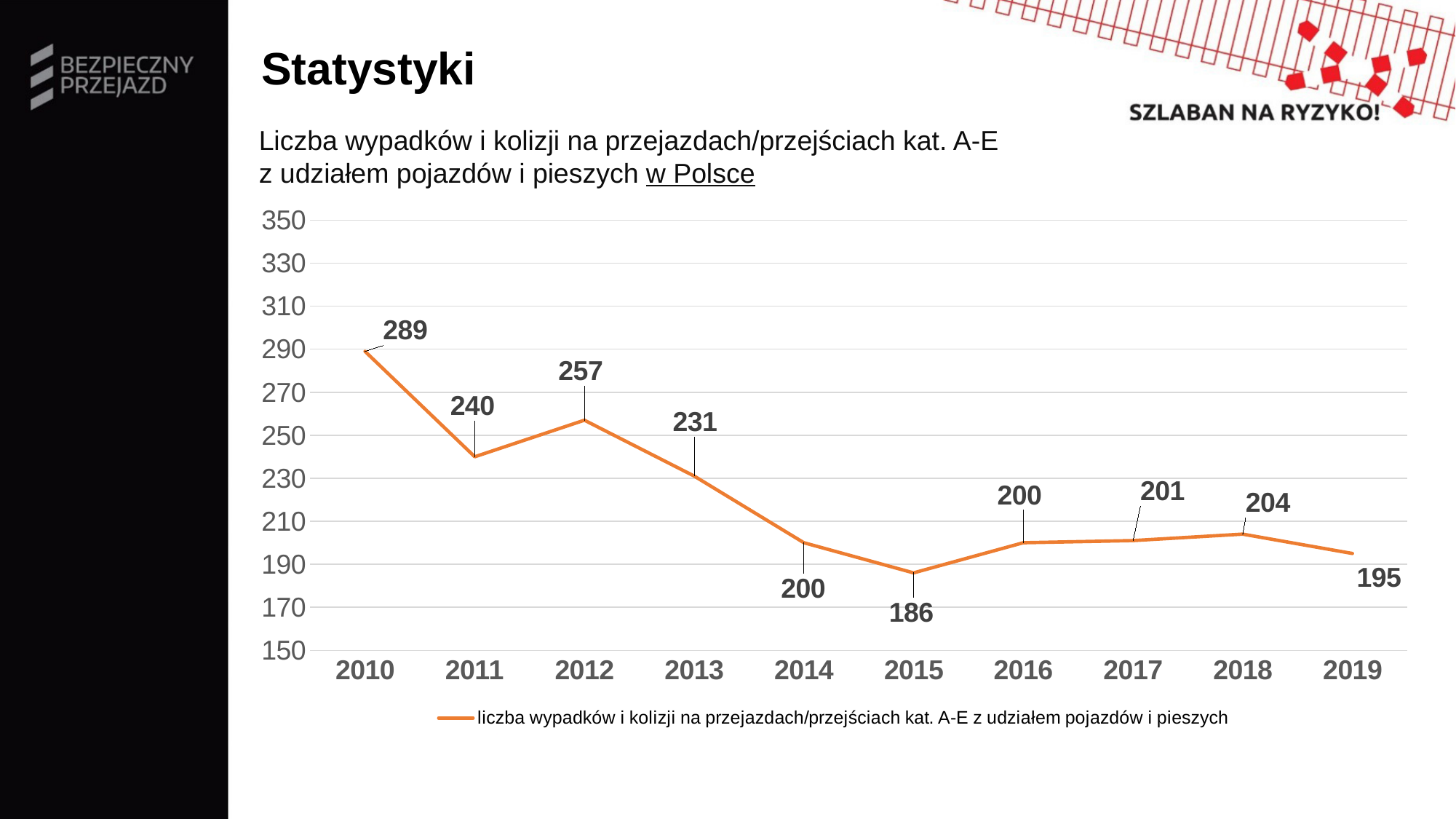
Which year has the lowest value? 2015 How many series does the legend list? 1 What is the value for 2010? 289 What is the value for 2019? 195 Which is larger, the value for 2011 or the value for 2012? 2012 Do the values generally rise or fall from 2010 to 2019? fall What is the difference between the values for 2010 and 2019? 94 How many years are plotted on the x axis? 10 Which year has the highest value? 2010 What is the value for 2015? 186 What kind of chart is shown on the slide? line chart What is the difference between the values for 2012 and 2013? 26